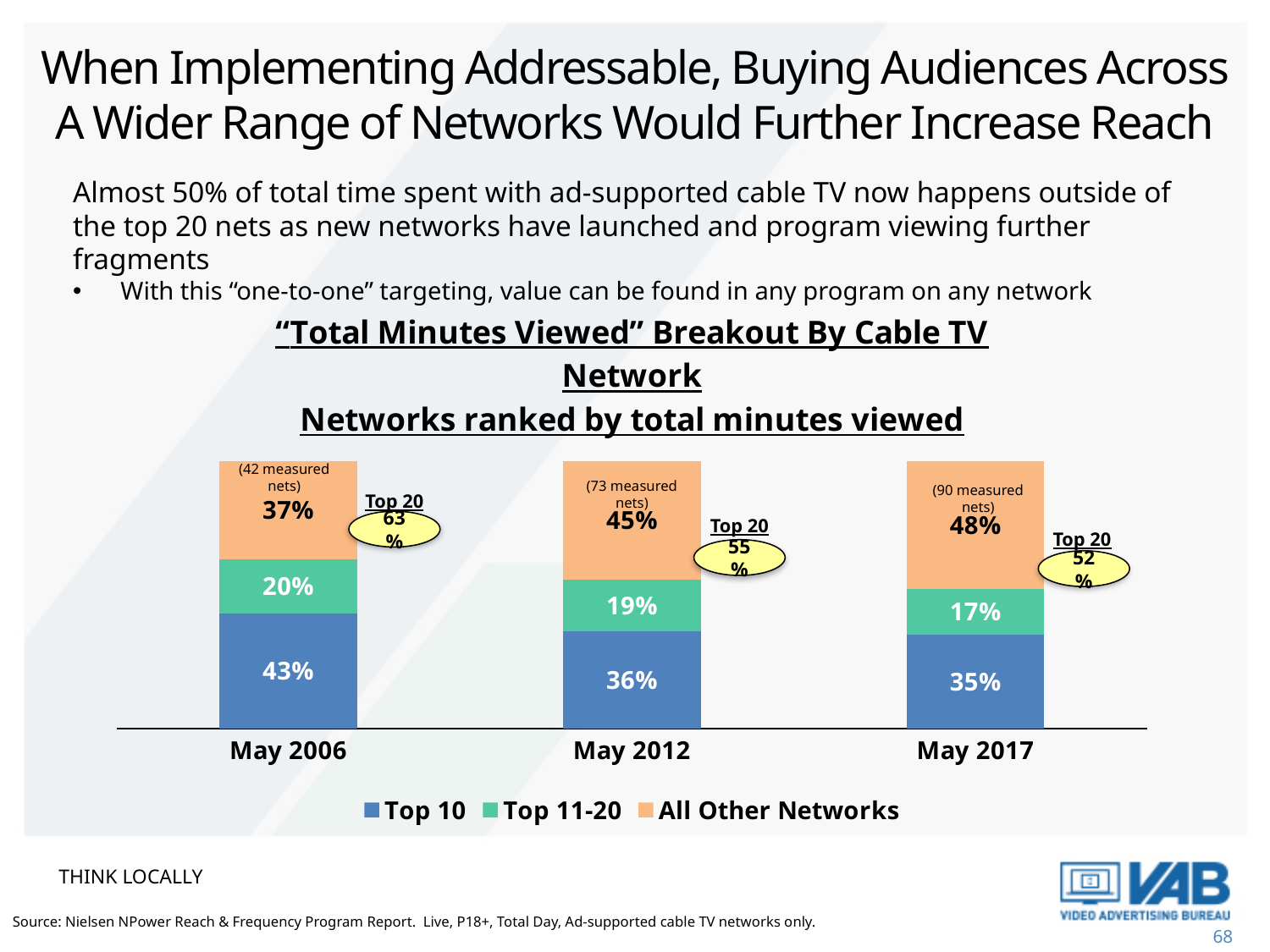
In which period is the Top 10 share the lowest? May 2017 How many time periods are shown on the x axis? 3 What kind of chart is shown on the slide? Stacked bar chart What is the All Other Networks share in May 2017? 48% In which period is the All Other Networks share the highest? May 2017 What Top 20 share is shown in the callout for May 2012? 55% What is the Top 11-20 share in May 2012? 19% How many series does the legend list? 3 What is the difference between the All Other Networks share in May 2017 and in May 2006? 11% What is the Top 10 share of total minutes viewed in May 2006? 43% Does the Top 10 share rise or fall from May 2006 to May 2017? Fall Which is larger: the Top 10 share in May 2006 or the Top 10 share in May 2012? May 2006